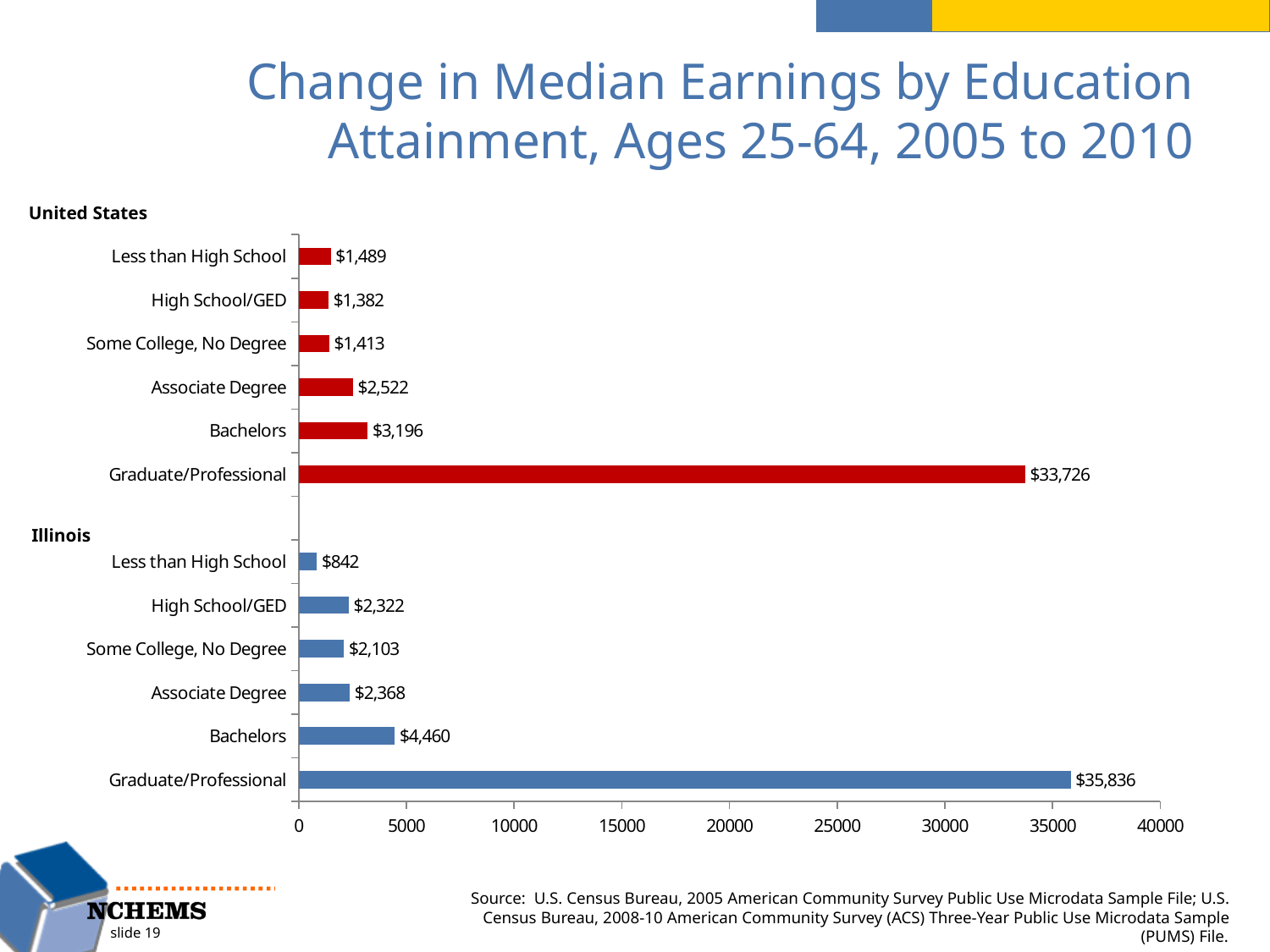
What is the change in median earnings for Graduate/Professional in the United States? $33,726 What is the change in median earnings for Bachelors in Illinois? $4,460 What is the change in median earnings for Less than High School in Illinois? $842 Which education level has the lowest change in median earnings in Illinois? Less than High School Which education level has the lowest change in median earnings in the United States? High School/GED Which education level has the highest change in median earnings in Illinois? Graduate/Professional What is the change in median earnings for Associate Degree in the United States? $2,522 What is the difference between the Bachelors values for Illinois and the United States? $1,264 What kind of chart is shown on the slide? Bar chart Which is larger, the High School/GED value for the United States or for Illinois? Illinois How many bars are plotted in the chart in total? 12 What is the difference between the Graduate/Professional values for Illinois and the United States? $2,110